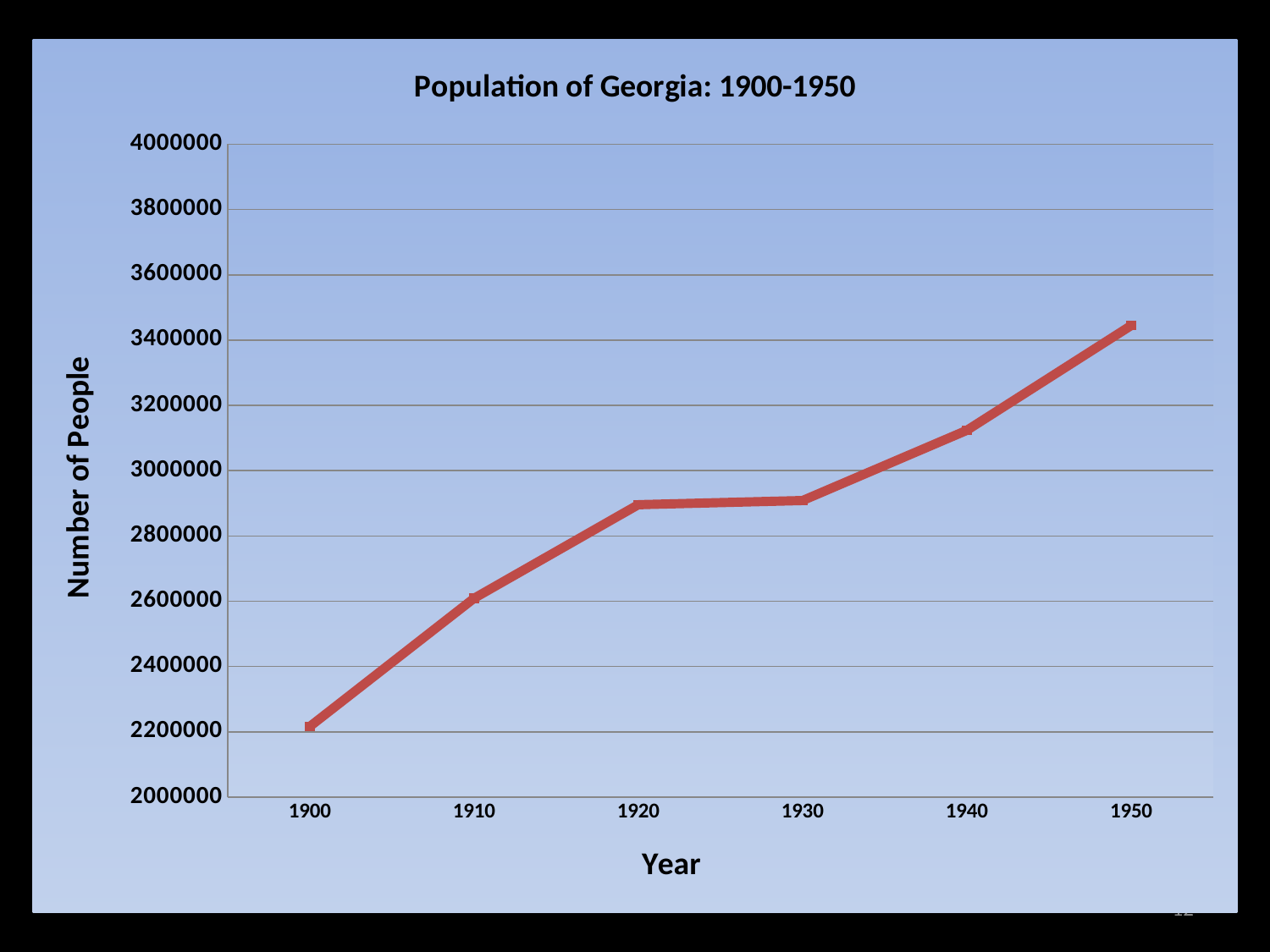
Is the population in 1900 greater or less than 2400000? less Is the population in 1930 greater or less than 2800000? greater What is the title of the chart? Population of Georgia: 1900-1950 Which year has the highest population? 1950 What is the label of the y axis? Number of People What kind of chart is shown on the slide? line chart Which year has the lowest population? 1900 Which year has the larger population, 1910 or 1940? 1940 Is the population in 1940 greater or less than 3000000? greater How many years are plotted on the x axis? 6 Does the population rise or fall from 1900 to 1950? rise